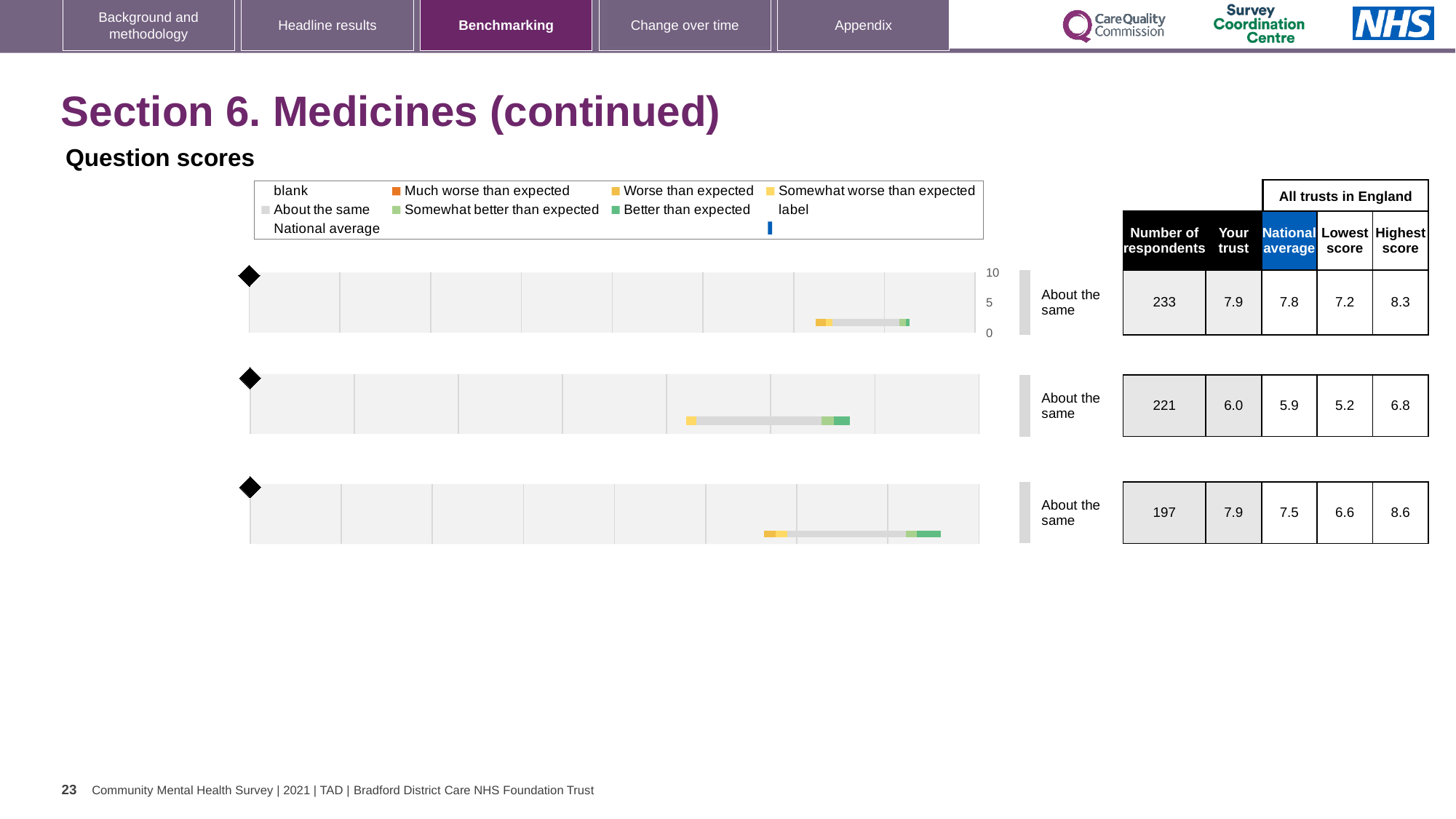
What is the highest value shown on the vertical axis scale next to the first chart? 10 In the second row, which is larger: the 'Your trust' score or the national average? Your trust In the third row, what is the number of respondents? 197 Which row has the highest 'Highest score' value across all trusts in England? the third row (8.6) In the first row, what is the difference between the 'Your trust' score and the national average? 0.1 In the first row, what is the 'Your trust' score? 7.9 What kind of chart is used to show the question scores on this slide? bar chart In the second row, what is the national average score? 5.9 What benchmark category is shown next to each of the three charts? About the same In the first chart, is the trust's score greater or less than 5? greater How many question score charts are shown on the slide? 3 Which row has the lowest 'Lowest score' value across all trusts in England? the second row (5.2)